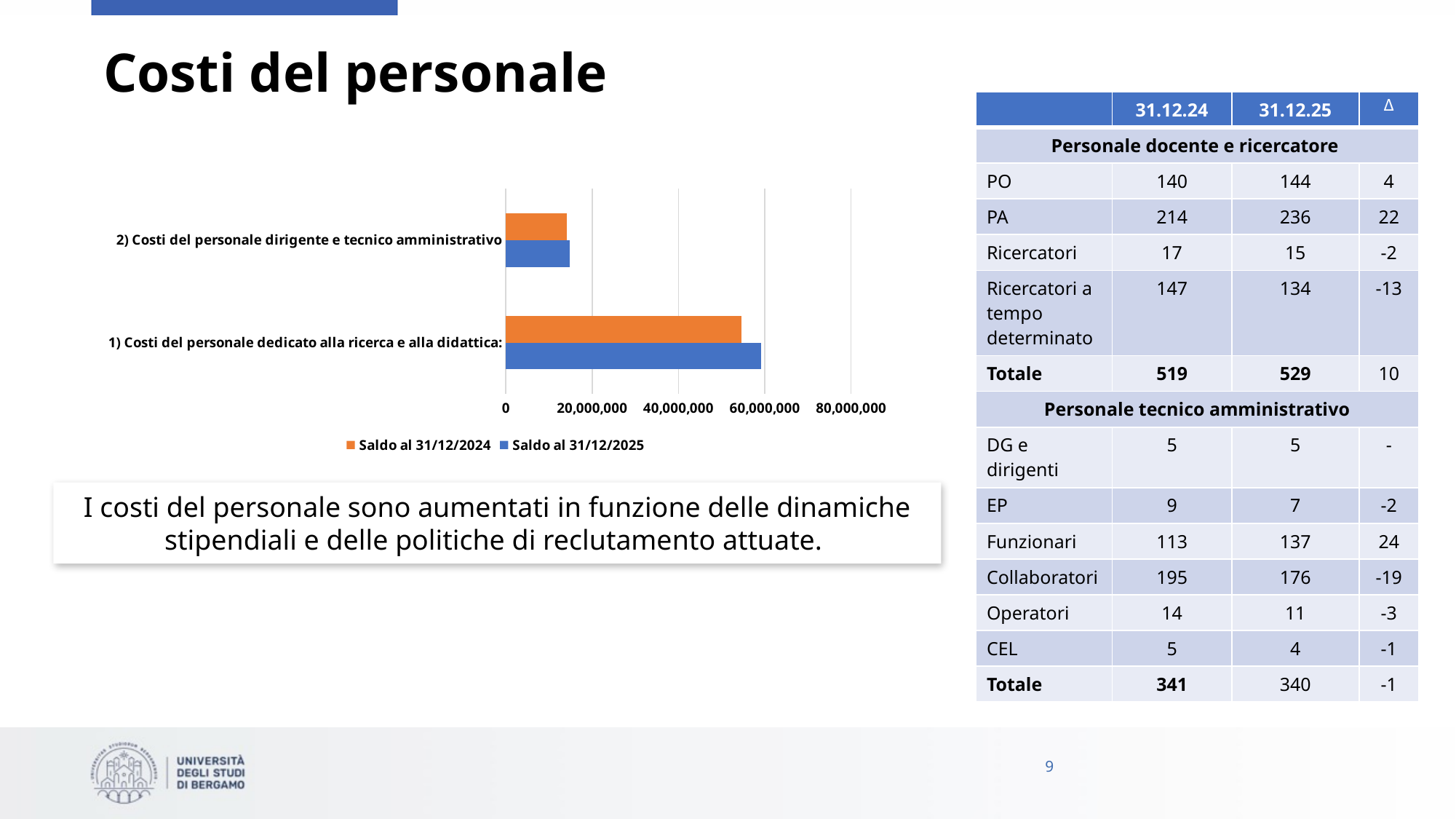
Which category has the lowest value for Saldo al 31/12/2024? 2) Costi del personale dirigente e tecnico amministrativo Is the Saldo al 31/12/2025 value for 2) Costi del personale dirigente e tecnico amministrativo greater or less than 20,000,000? less Which series is shown in orange in the chart? Saldo al 31/12/2024 How many categories does the chart show? 2 Is the Saldo al 31/12/2025 value for 1) Costi del personale dedicato alla ricerca e alla didattica greater or less than 40,000,000? greater What is the highest value shown on the chart's horizontal axis? 80,000,000 How many series does the chart's legend list? 2 Which category has the highest value for Saldo al 31/12/2025? 1) Costi del personale dedicato alla ricerca e alla didattica What kind of chart is shown on the slide? bar chart Is the Saldo al 31/12/2024 value for 1) Costi del personale dedicato alla ricerca e alla didattica greater or less than 60,000,000? less For 1) Costi del personale dedicato alla ricerca e alla didattica, which series is larger: Saldo al 31/12/2024 or Saldo al 31/12/2025? Saldo al 31/12/2025